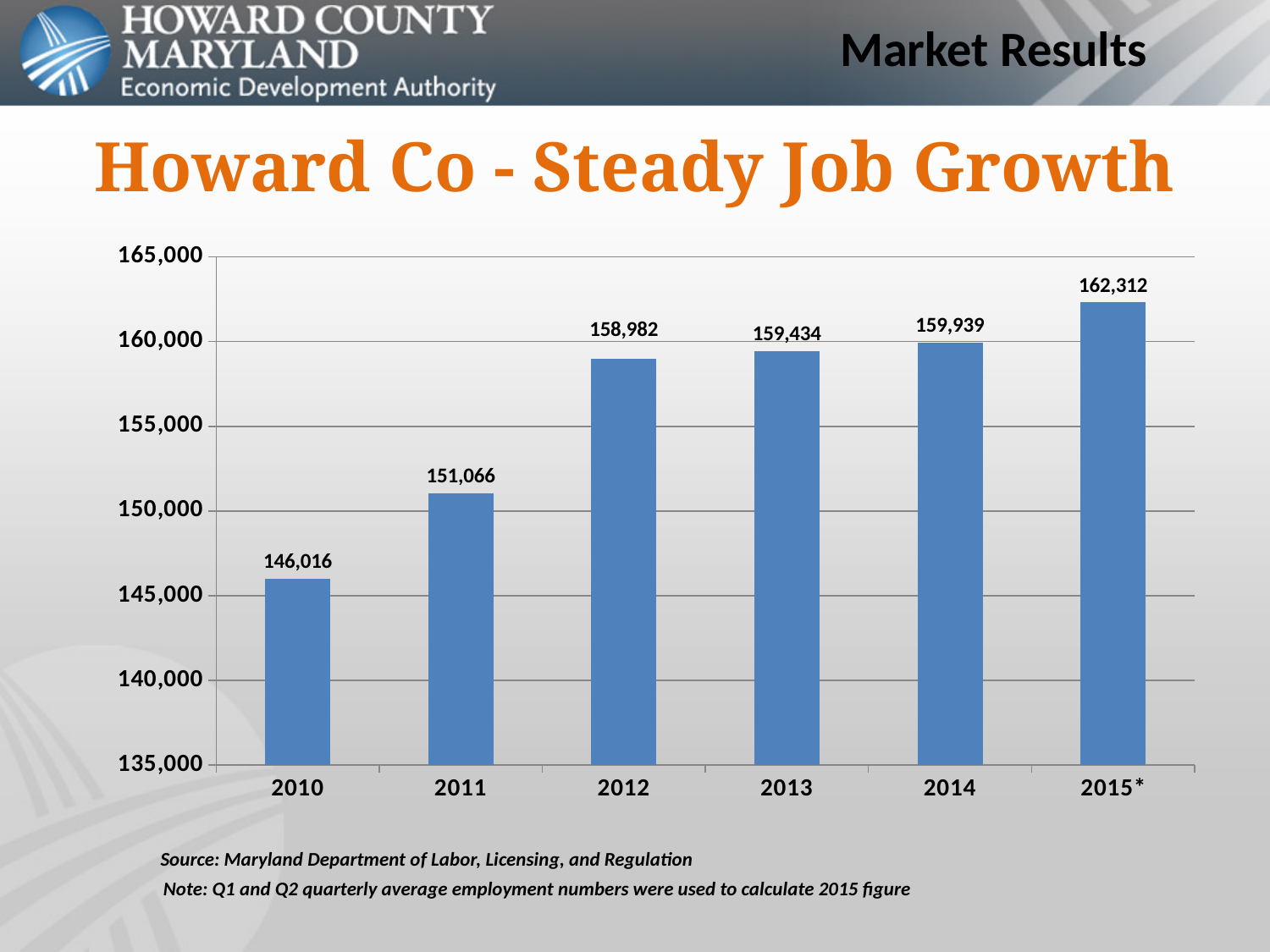
Which year has the highest value? 2015* What is the value for 2013? 159,434 Do the values rise or fall from 2010 to 2015*? rise What is the value for 2015*? 162,312 Which is larger, the value for 2012 or the value for 2011? 2012 What kind of chart is this? bar chart Is the value for 2014 greater or less than 155,000? greater How many years are shown on the x axis? 6 What is the value for 2010? 146,016 What is the difference between the values for 2015* and 2014? 2,373 Which year has the lowest value? 2010 What is the difference between the values for 2011 and 2010? 5,050